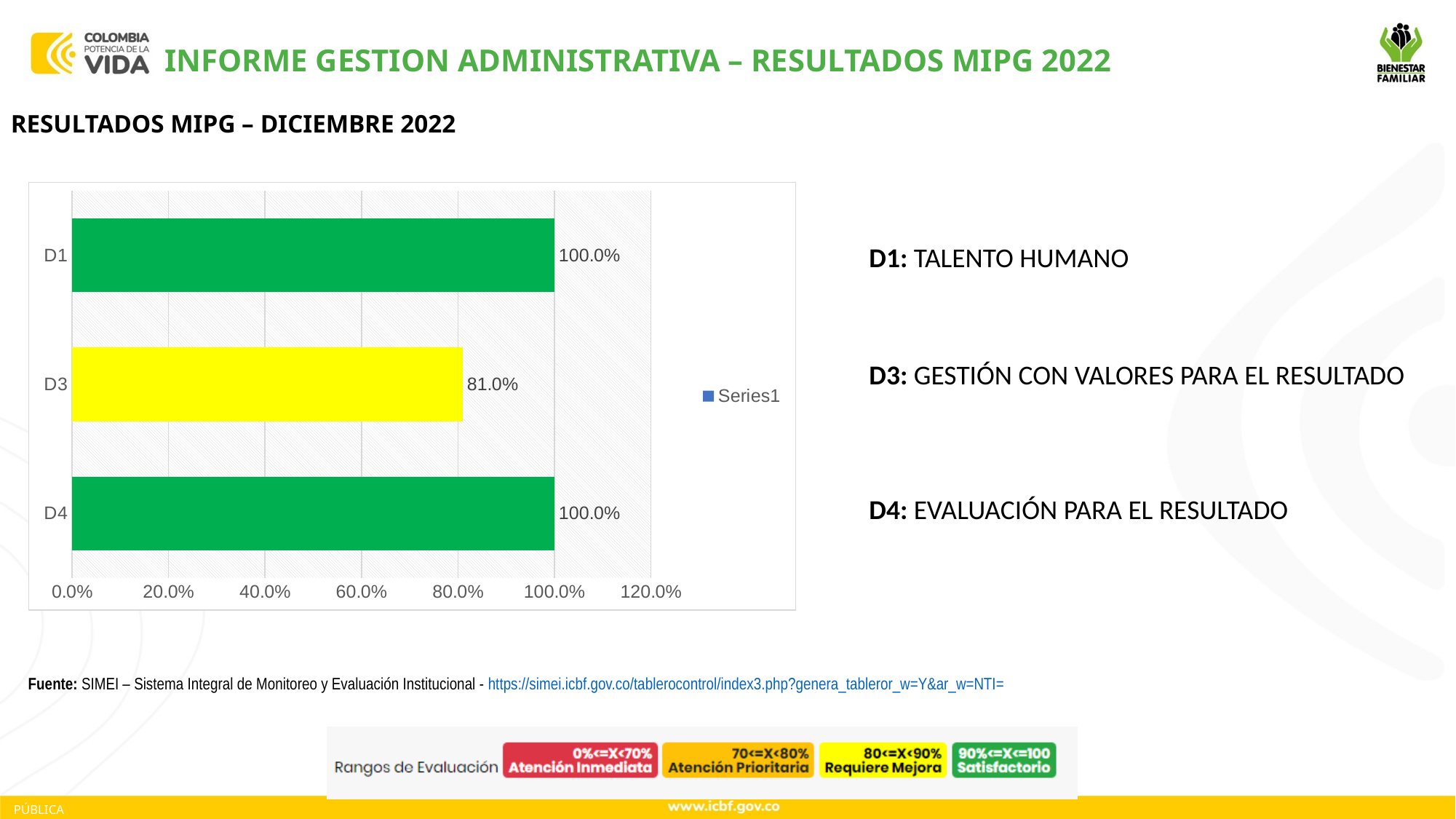
Is the value for D3 greater or less than 100.0%? less Which category has the lowest value? D3 How many categories are shown in the chart? 3 What is the difference between the values for D1 and D3? 19.0% What is the value for D1? 100.0% How many series does the legend list? 1 What kind of chart is shown on the slide? bar chart Which is larger, the value for D3 or the value for D4? D4 What is the value for D4? 100.0% What is the value for D3? 81.0% What colour is the bar for D3? yellow What is the name of the series listed in the legend? Series1